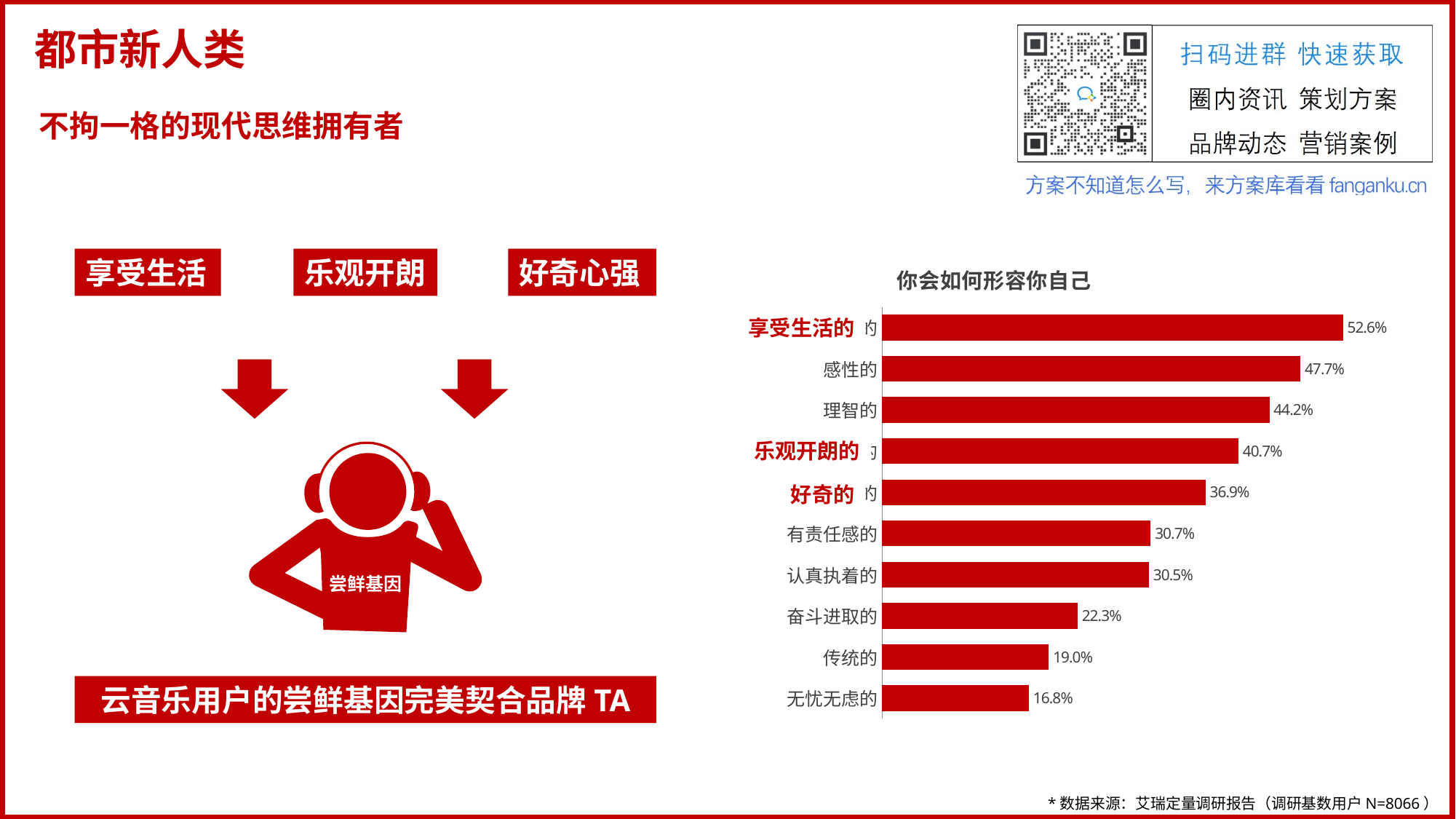
What is the title of the chart? 你会如何形容你自己 What is the difference between the values for 享受生活的 and 乐观开朗的? 11.9% Which is larger, the value for 理智的 or the value for 有责任感的? 理智的 What is the value for 好奇的 in the chart? 36.9% Which category has the lowest value in the chart? 无忧无虑的 What is the difference between the values for 传统的 and 无忧无虑的? 2.2% What is the value for 理智的 in the chart? 44.2% How many categories are shown in the chart? 10 What is the value for 感性的 in the chart? 47.7% What is the value for 奋斗进取的 in the chart? 22.3% Which category has the highest value in the chart? 享受生活的 What kind of chart is shown on the slide? Bar chart